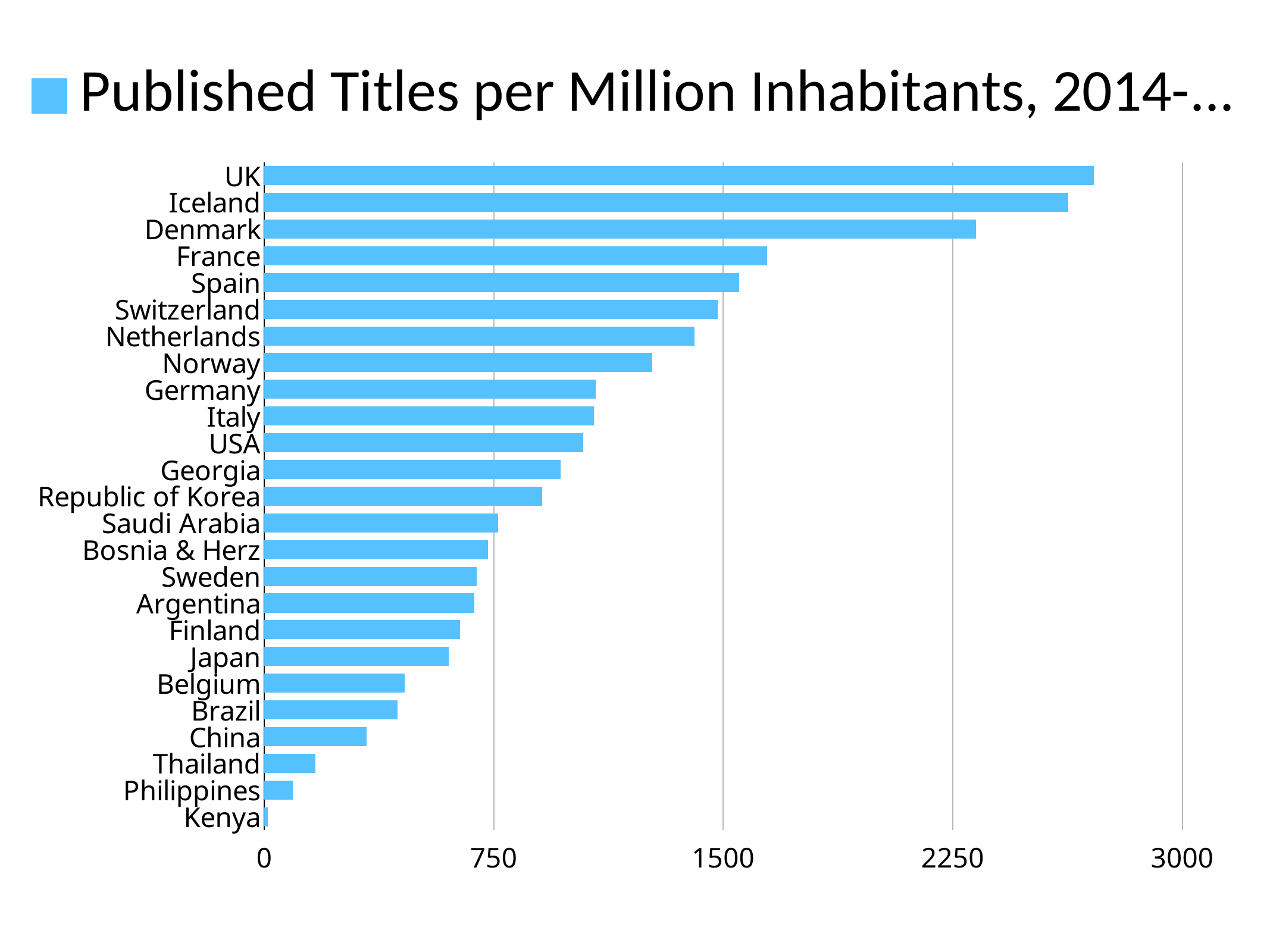
Do the bar values increase or decrease going from the top of the chart to the bottom? decrease How many countries are listed on the chart? 25 How many series does the legend list? 1 Is the value for Netherlands greater or less than 1500? less Which has a higher value, China or Thailand? China Is the value for the UK greater or less than 2250? greater Is the value for France greater or less than 1500? greater Which country has the highest number of published titles per million inhabitants? UK Which country has the lowest number of published titles per million inhabitants? Kenya Which has a higher value, France or Spain? France What kind of chart is shown on the slide? bar chart